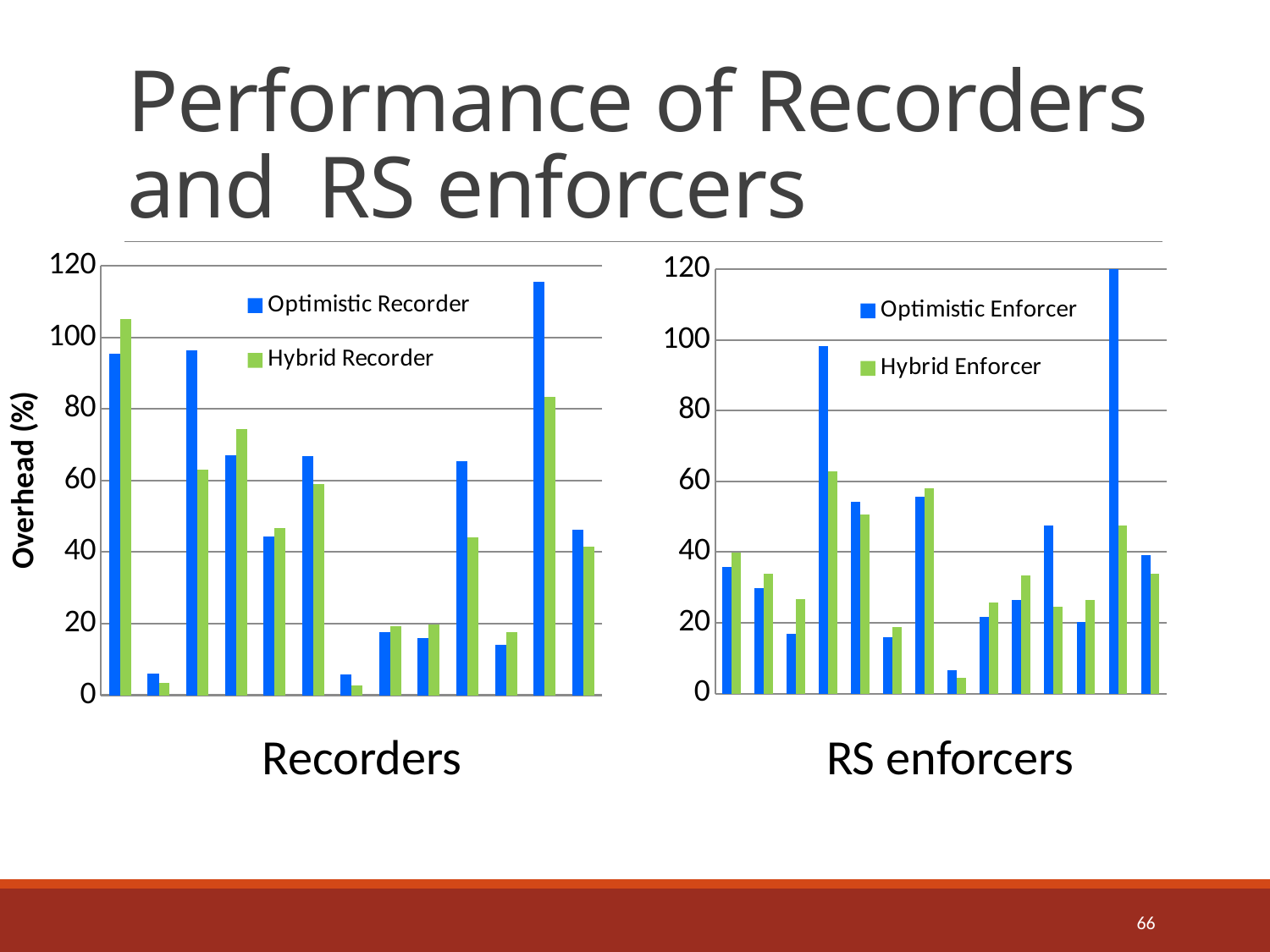
In the RS enforcers chart, is the tallest Optimistic Enforcer bar greater or less than 100? greater How many groups of bars are plotted in the Recorders chart? 13 How many groups of bars are plotted in the RS enforcers chart? 14 In the third group from the left of the Recorders chart, which bar is taller, Optimistic Recorder or Hybrid Recorder? Optimistic Recorder What is the y-axis title shown on the Recorders chart? Overhead (%) In the Recorders chart, is the tallest Optimistic Recorder bar greater or less than 100? greater In the Recorders chart, is the Hybrid Recorder bar in the leftmost group greater or less than 100? greater What kind of chart is the Recorders chart on the left? bar chart In the leftmost group of the Recorders chart, which bar is taller, Optimistic Recorder or Hybrid Recorder? Hybrid Recorder What are the two series named in the legend of the Recorders chart? Optimistic Recorder and Hybrid Recorder How many series does the legend of the RS enforcers chart list? 2 In the RS enforcers chart, which series has the single tallest bar? Optimistic Enforcer